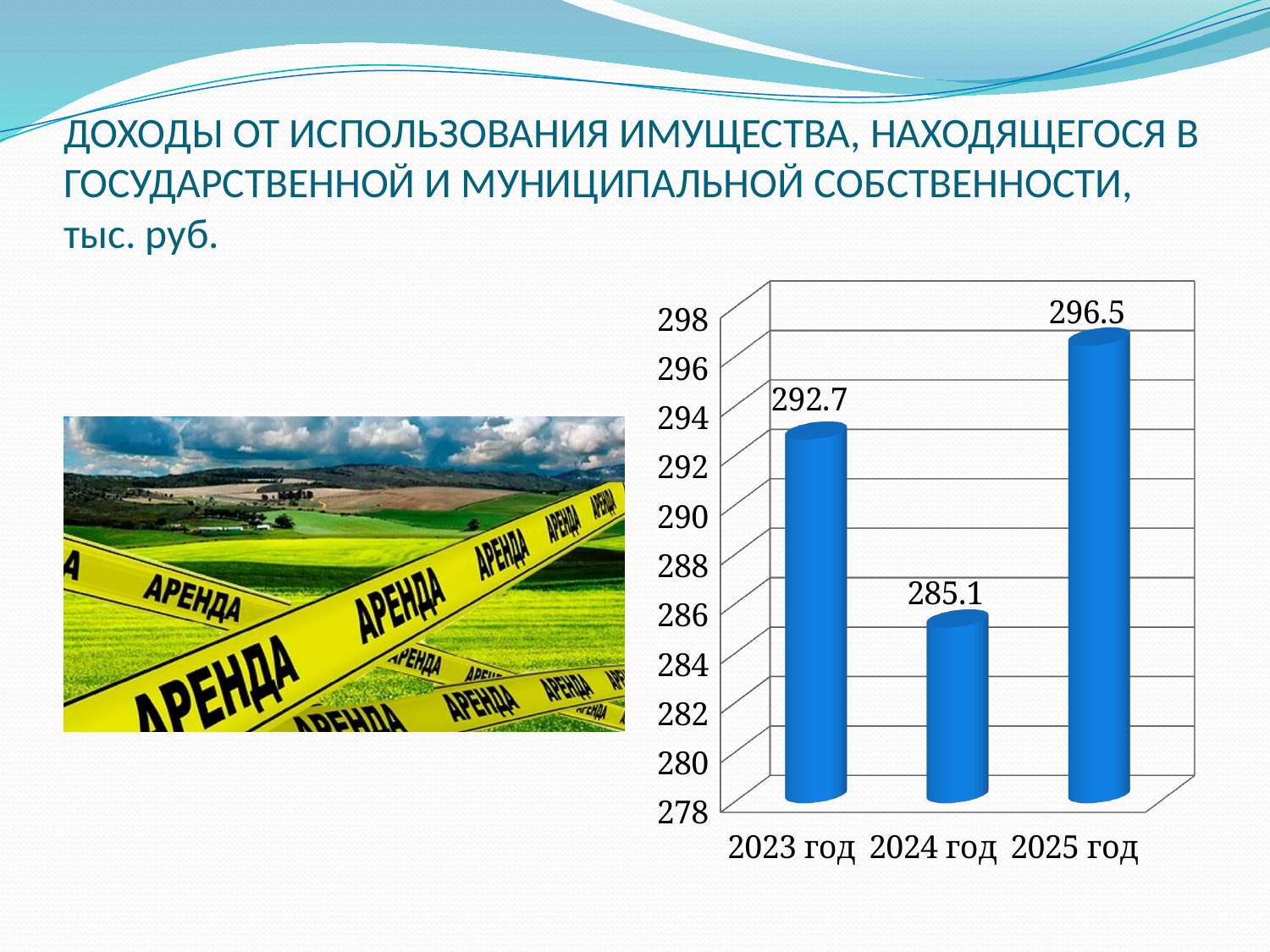
How many years are shown on the chart? 3 What is the value for 2023 год? 292.7 Is the value for 2024 год greater or less than 290? less Which year has the lowest value? 2024 год What unit of measurement is stated in the slide title? тыс. руб. What is the difference between the values for 2025 год and 2024 год? 11.4 What is the difference between the values for 2023 год and 2024 год? 7.6 Which year has the highest value? 2025 год What kind of chart is shown on the slide? bar chart Which is larger, the value for 2023 год or the value for 2025 год? 2025 год What is the value for 2024 год? 285.1 What is the value for 2025 год? 296.5